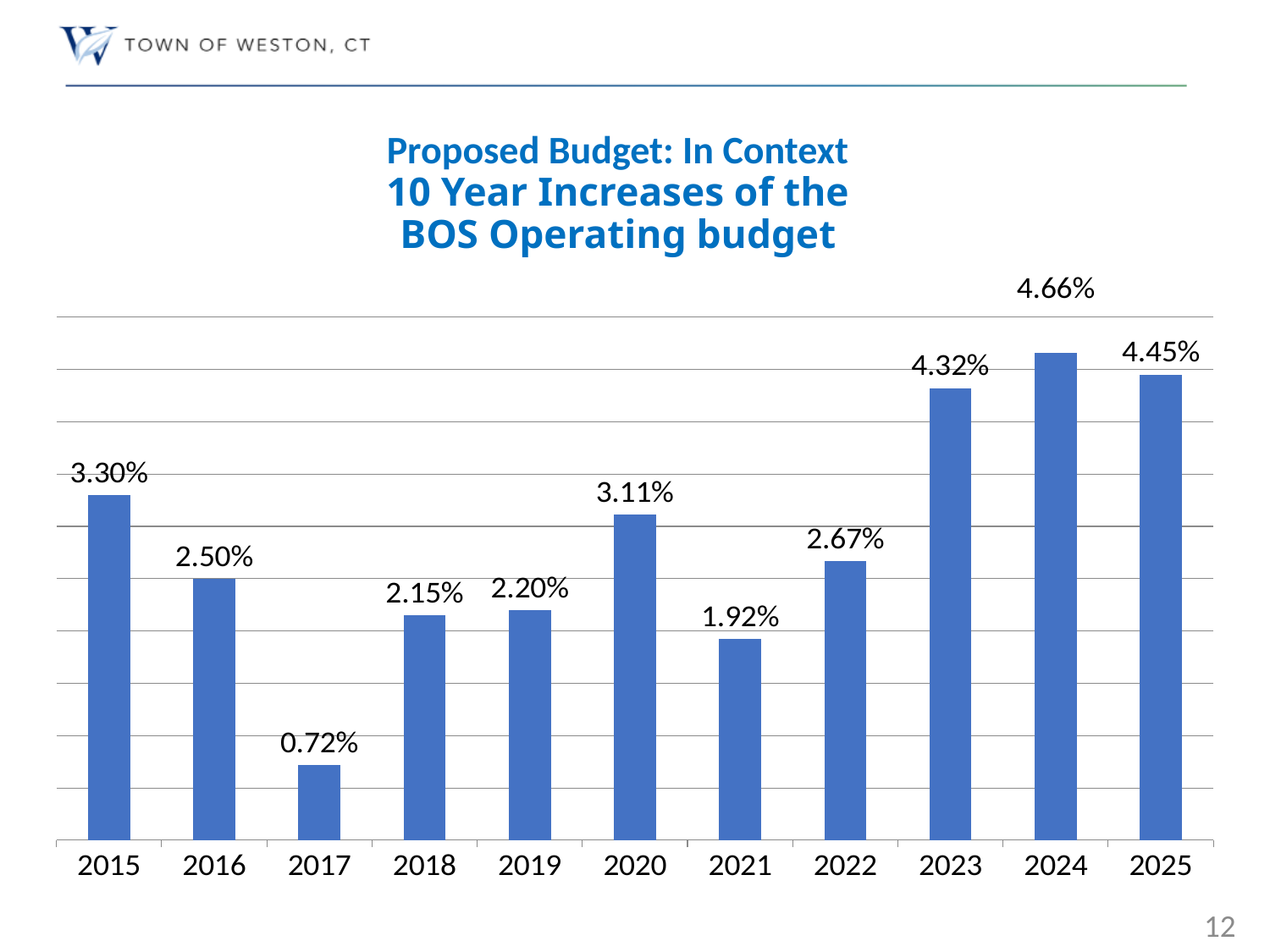
What is the difference between the 2024 and 2025 increases? 0.21% What is the increase shown for 2023? 4.32% Do the values rise or fall from 2021 to 2024? Rise Which year has the larger increase, 2019 or 2022? 2022 Which year has the larger increase, 2021 or 2018? 2018 What is the increase shown for 2020? 3.11% Which year has the highest increase? 2024 What is the increase shown for 2017? 0.72% What is the difference between the 2015 and 2016 increases? 0.80% What kind of chart is shown on the slide? Bar chart How many years are shown on the chart? 11 Which year has the lowest increase? 2017